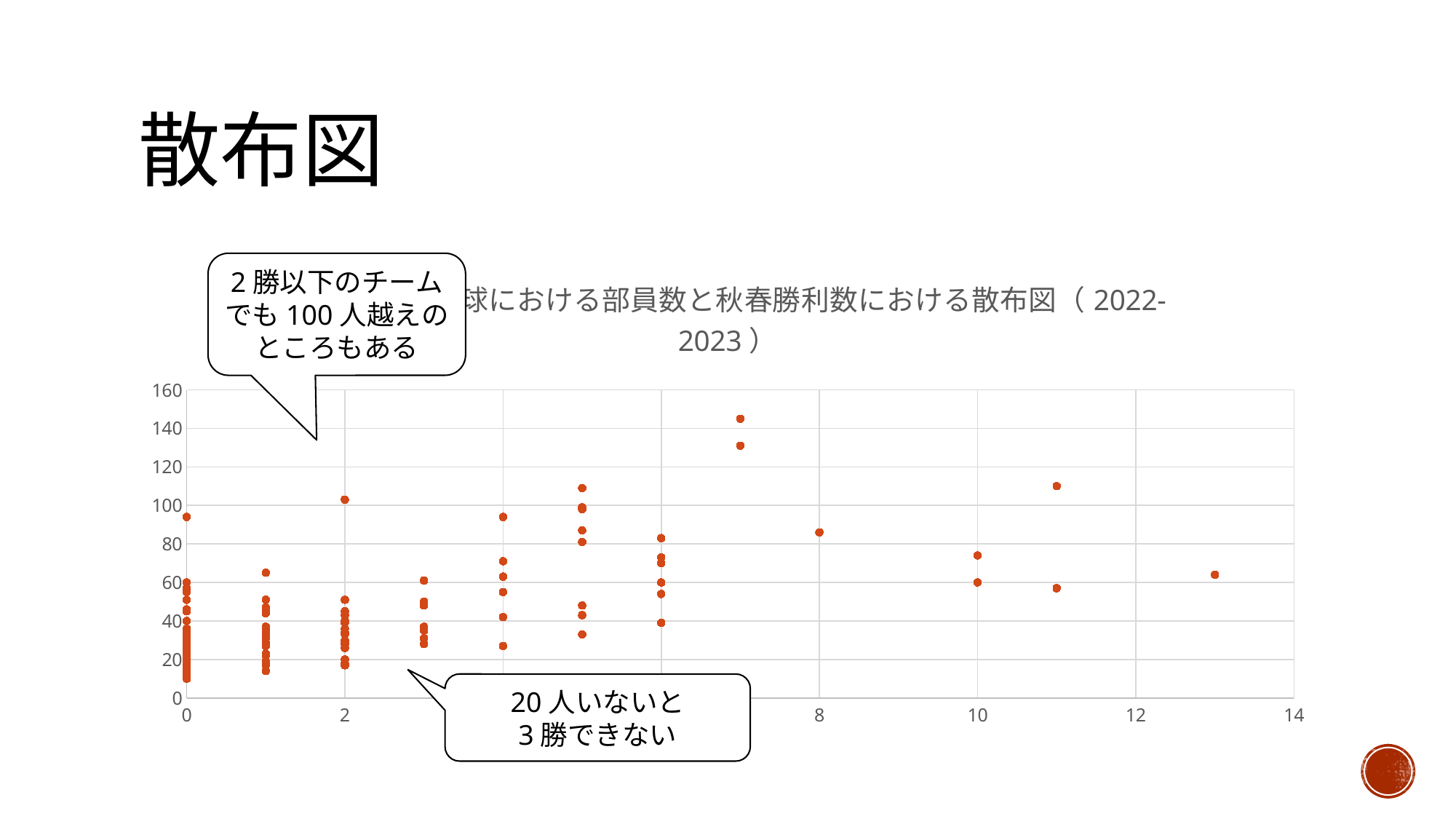
What is the highest value shown on the vertical axis? 160 Is the lowest point at x = 0 greater or less than 20 on the vertical axis? less Which has the higher vertical-axis value: the highest point at x = 7 or the highest point at x = 11? the highest point at x = 7 What is the highest value shown on the horizontal axis? 14 Is the vertical-axis value of the point at x = 8 greater or less than 80? greater Is the highest point at x = 2 greater or less than 120 on the vertical axis? less Which years does the chart title say the data covers? 2022-2023 What kind of chart is shown on the slide? scatter chart